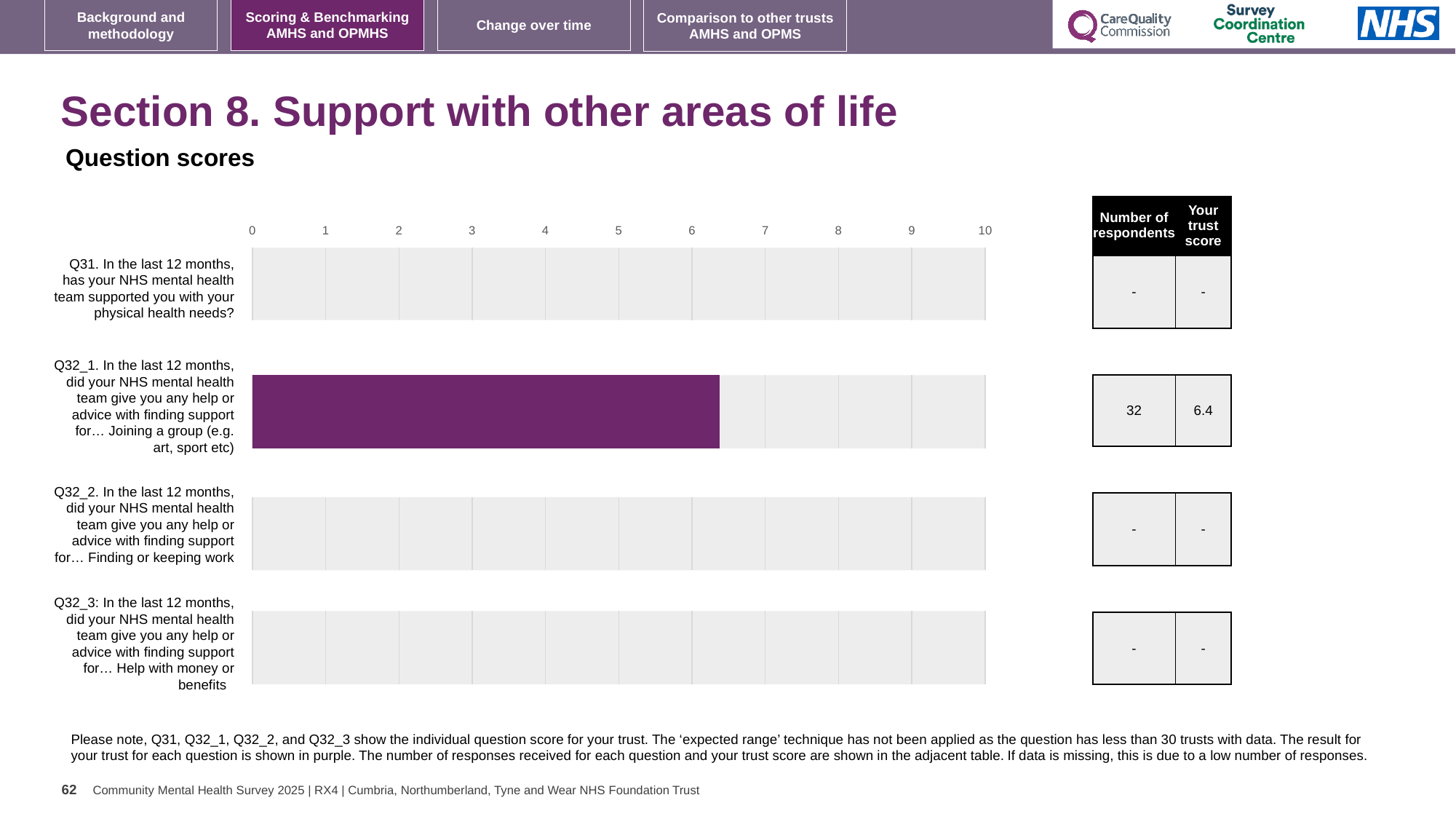
What kind of chart is shown on the slide? bar chart How many respondents are shown for Q32_1 in the adjacent table? 32 Which question is the only one with a plotted bar on the chart? Q32_1 What is the maximum value shown on the chart's axis? 10 What colour is the bar showing the trust's result for Q32_1? purple What is the trust score for Q32_1 (help or advice with joining a group)? 6.4 What is shown as the trust score for Q31 (support with physical health needs)? - What is shown as the number of respondents for Q32_3 (help with money or benefits)? - Is the value for Q32_1 greater or less than 6? greater Is the value for Q32_1 greater or less than 7? less How many questions (categories) are listed on the chart? 4